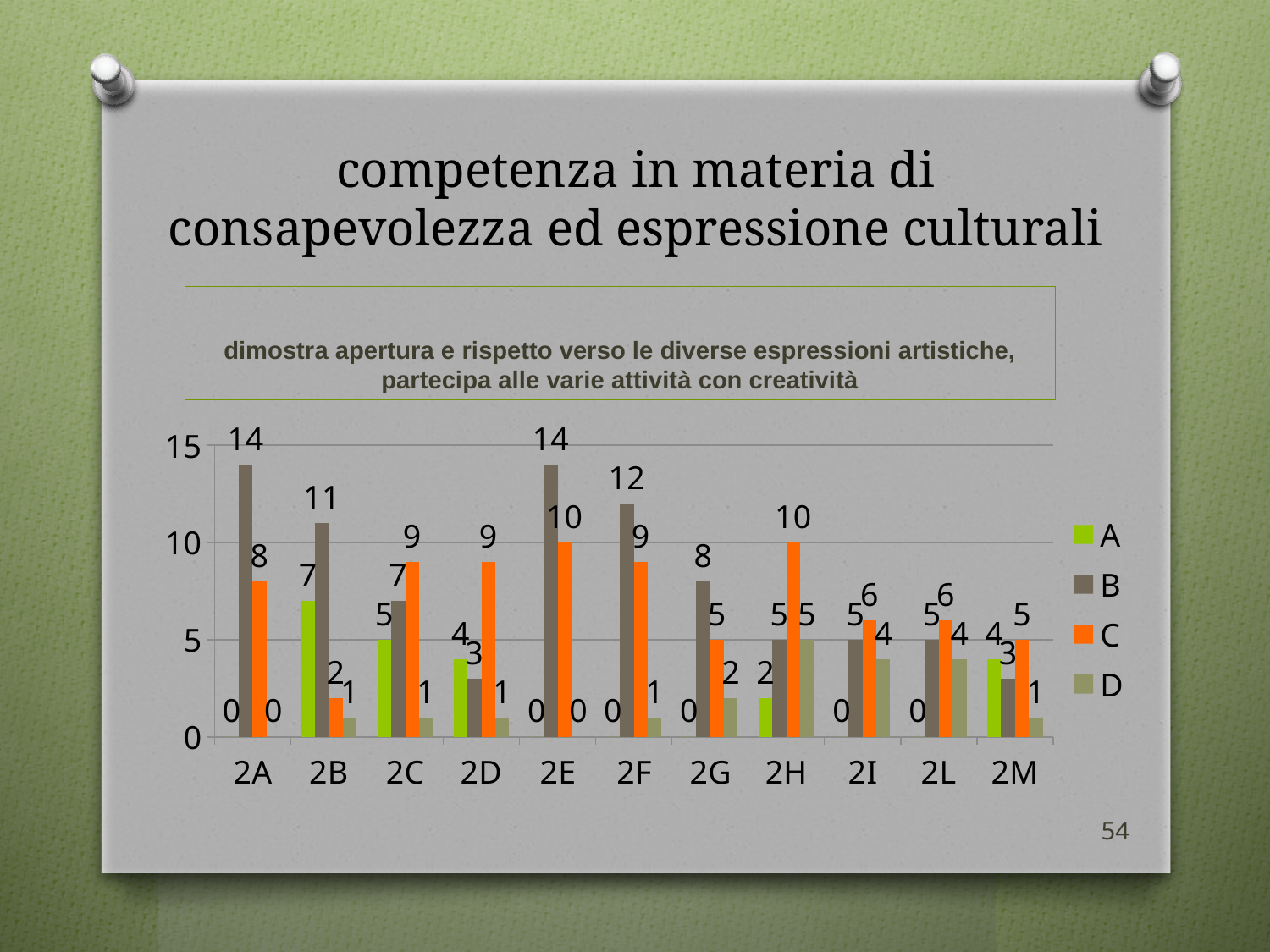
What kind of chart is shown on the slide? Bar chart Which class has the lowest value for series B? 2D and 2M For class 2C, which is larger, series B or series C? C What is the value of series D for class 2I? 4 Which class has the highest value for series C? 2E and 2H What is the difference between series B and series C for class 2F? 3 What is the value of series A for class 2B? 7 What is the value of series B for class 2A? 14 How many classes are shown on the x axis? 11 How many series does the legend list? 4 What is the total of all four series for class 2H? 22 What is the value of series C for class 2H? 10